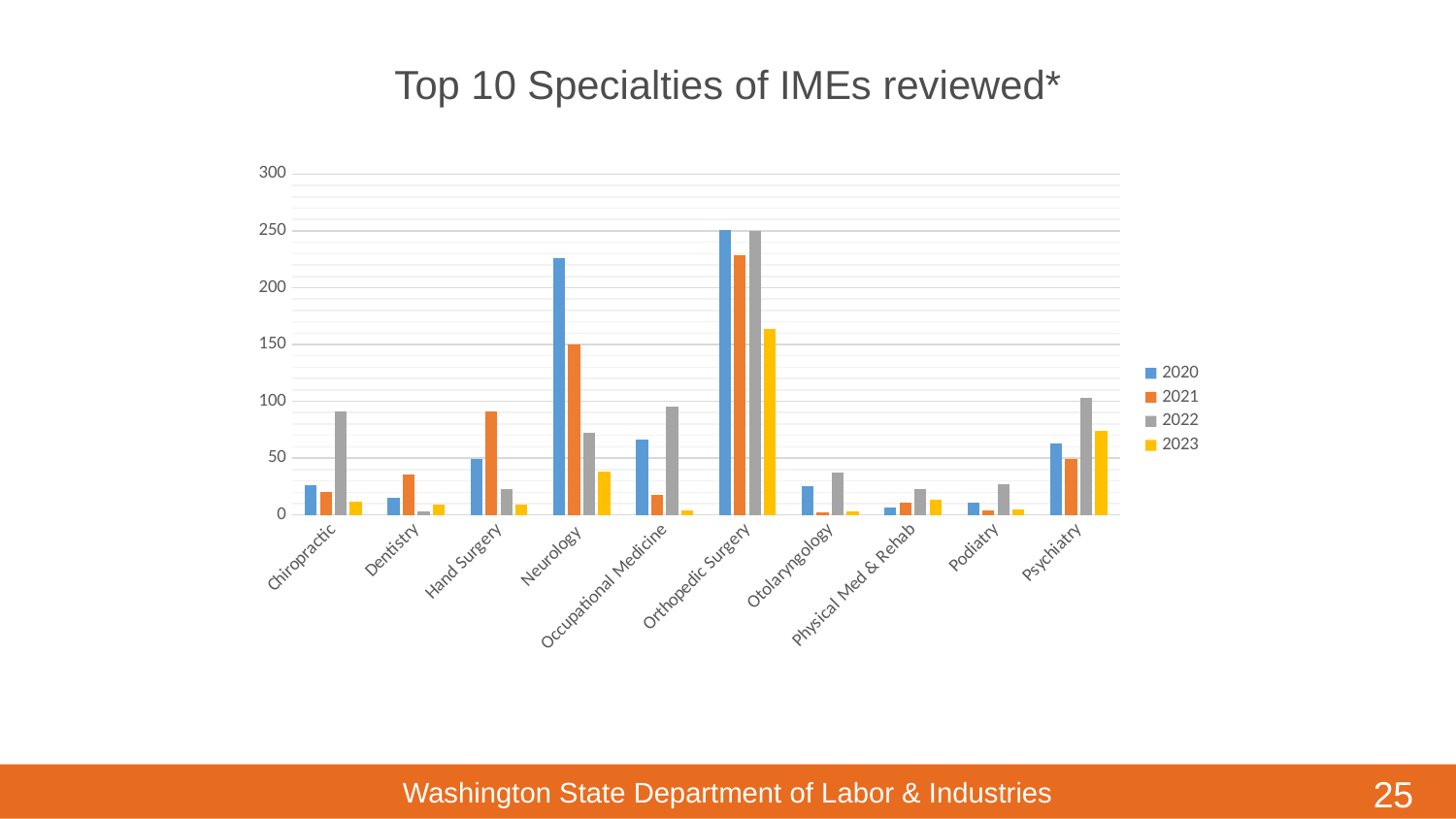
Which year has the highest value for Psychiatry? 2022 How many specialties are shown on the x axis of the chart? 10 Do the values for Neurology rise or fall from 2020 to 2023? fall Is the 2020 value for Neurology greater or less than 200? greater How many series does the chart's legend list? 4 What is the title of the chart on the slide? Top 10 Specialties of IMEs reviewed* Which specialty has the highest value for 2020? Orthopedic Surgery Is the 2022 value for Occupational Medicine greater or less than 50? greater For Chiropractic, which year has the larger value, 2020 or 2022? 2022 For Hand Surgery, which year has the larger value, 2021 or 2022? 2021 What kind of chart is shown on the slide? bar chart Is the 2023 value for Orthopedic Surgery greater or less than 150? greater